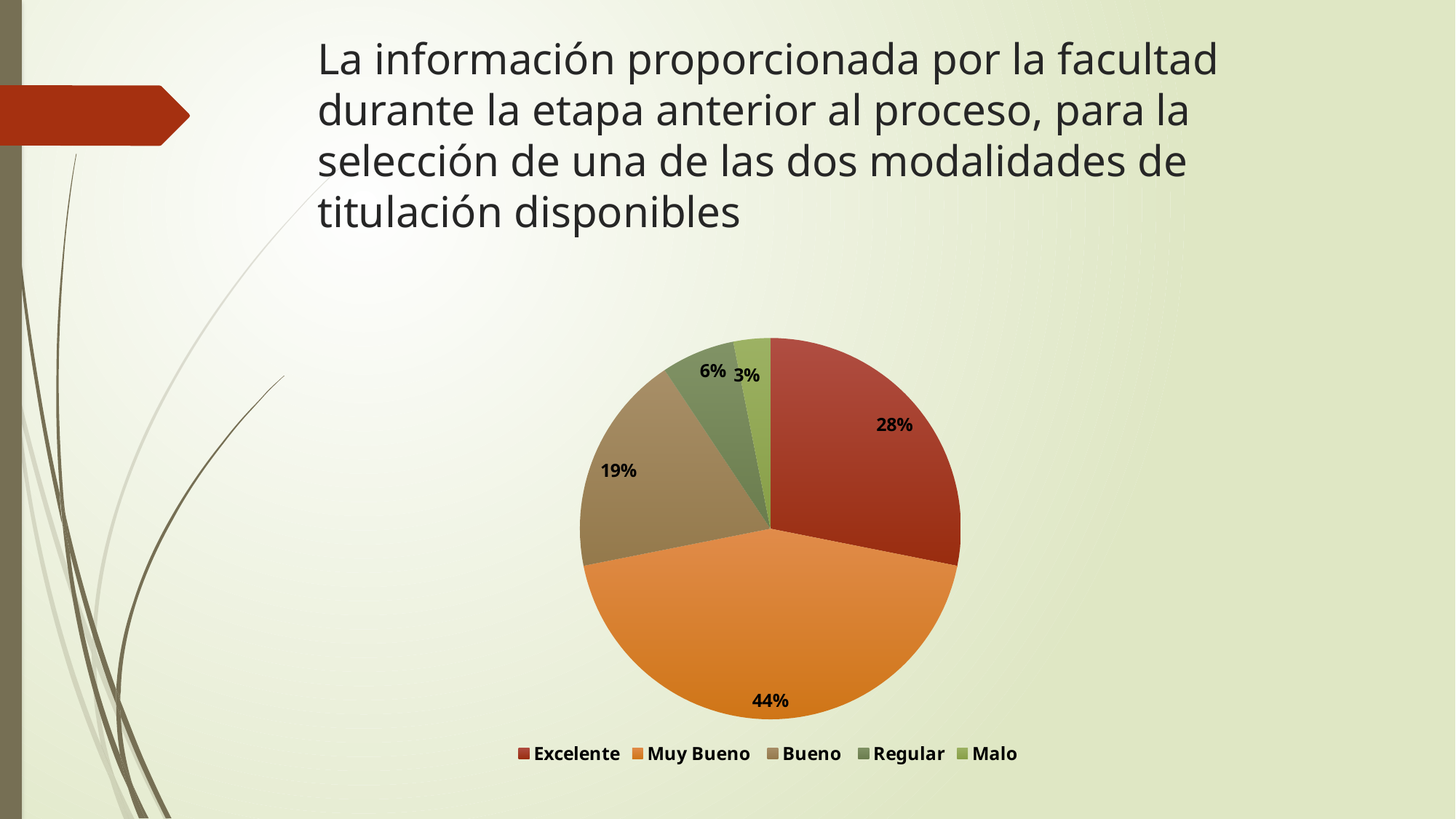
Which category has the largest slice of the pie? Muy Bueno What colour is the Muy Bueno slice? orange Which slice is larger, Bueno or Regular? Bueno What percentage of the pie is labelled Excelente? 28% What percentage of the pie is labelled Muy Bueno? 44% What percentage of the pie is labelled Malo? 3% What kind of chart is shown on the slide? pie chart What is the difference in percentage points between the Muy Bueno and Excelente slices? 16 What percentage of the pie is labelled Bueno? 19% How many categories does the legend list? 5 What percentage of the pie is labelled Regular? 6% Which category has the smallest slice of the pie? Malo